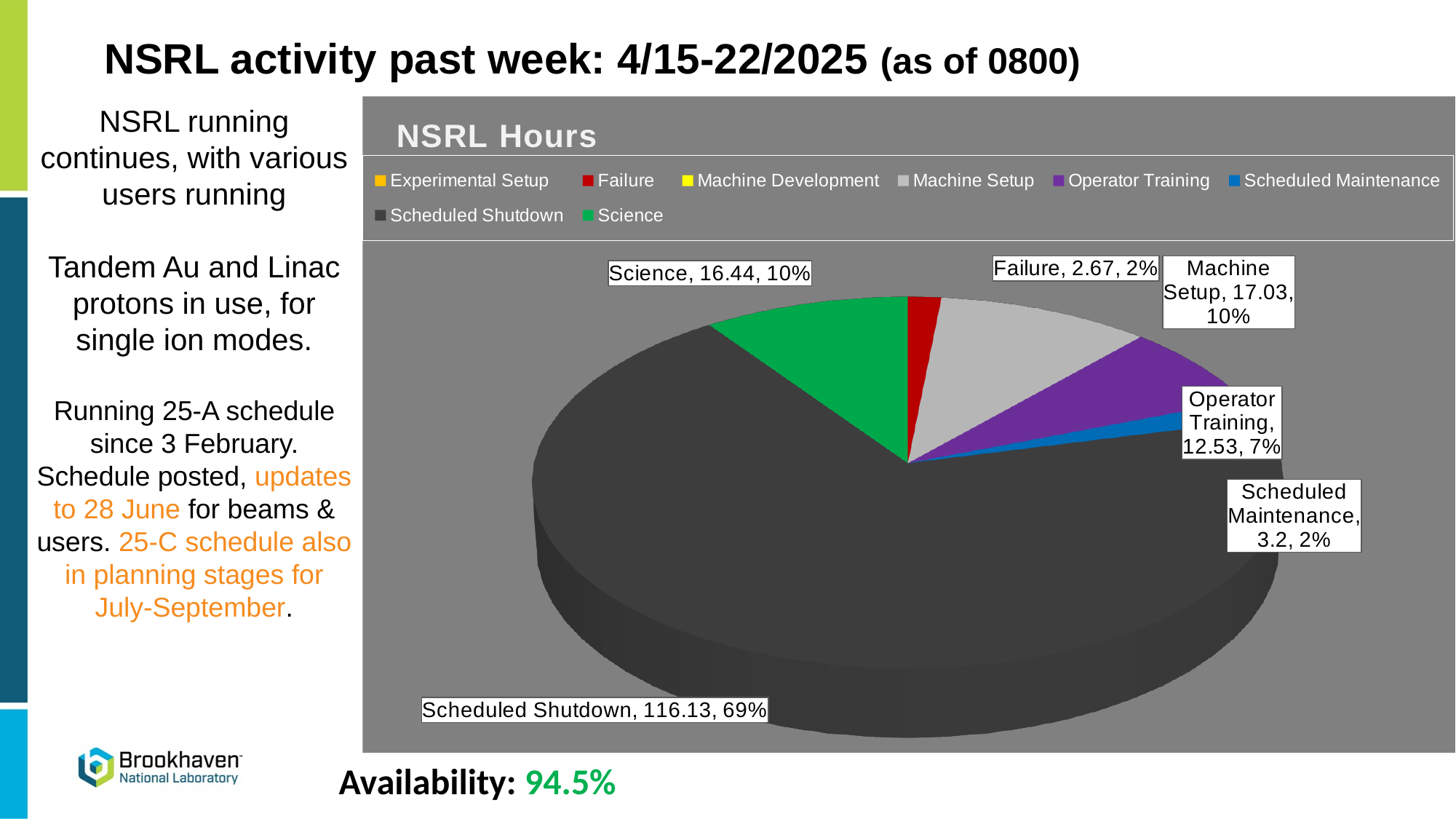
What is the title of the chart? NSRL Hours Which category has the largest slice of the pie? Scheduled Shutdown What share of the pie does Scheduled Shutdown represent? 69% How many entries does the legend list? 8 Which has more hours, Scheduled Maintenance or Failure? Scheduled Maintenance What is the difference in hours between Machine Setup and Science? 0.59 How many hours are shown for Machine Setup? 17.03 How many hours are shown for Operator Training? 12.53 What share of the pie does Science represent? 10% Which labelled category has the smallest number of hours? Failure How many hours are shown for Scheduled Shutdown? 116.13 What type of chart is shown on the slide? pie chart